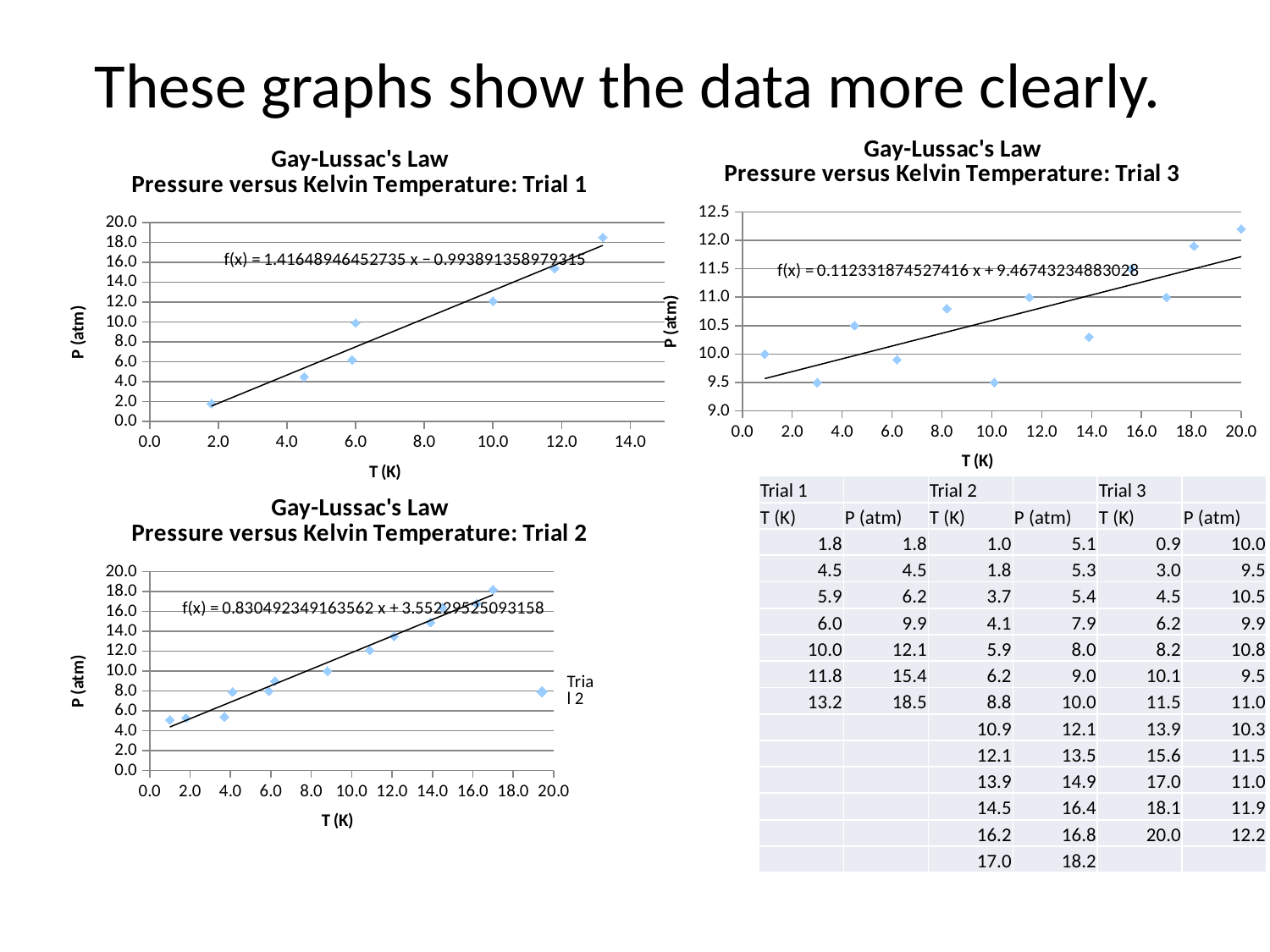
In the Trial 1 chart, what is the pressure at T = 13.2 K? 18.5 In the Trial 3 chart, is the pressure at T = 20.0 K greater or less than 12.0? greater In the Trial 1 chart, how many data points are plotted? 7 In the Trial 2 chart, what is the lowest pressure value plotted? 5.1 In the Trial 2 chart, do the pressure values generally rise or fall as temperature increases? rise In the Trial 1 chart, what is the difference between the highest and lowest pressure values? 16.7 In the Trial 2 chart, what is the pressure at T = 17.0 K? 18.2 In the Trial 3 chart, what is the pressure at T = 20.0 K? 12.2 In the Trial 2 chart, how many data points are plotted? 13 What kind of chart is the Trial 1 chart? scatter chart In the Trial 3 chart, how many data points are plotted? 12 In the Trial 1 chart, what is the highest pressure value plotted? 18.5